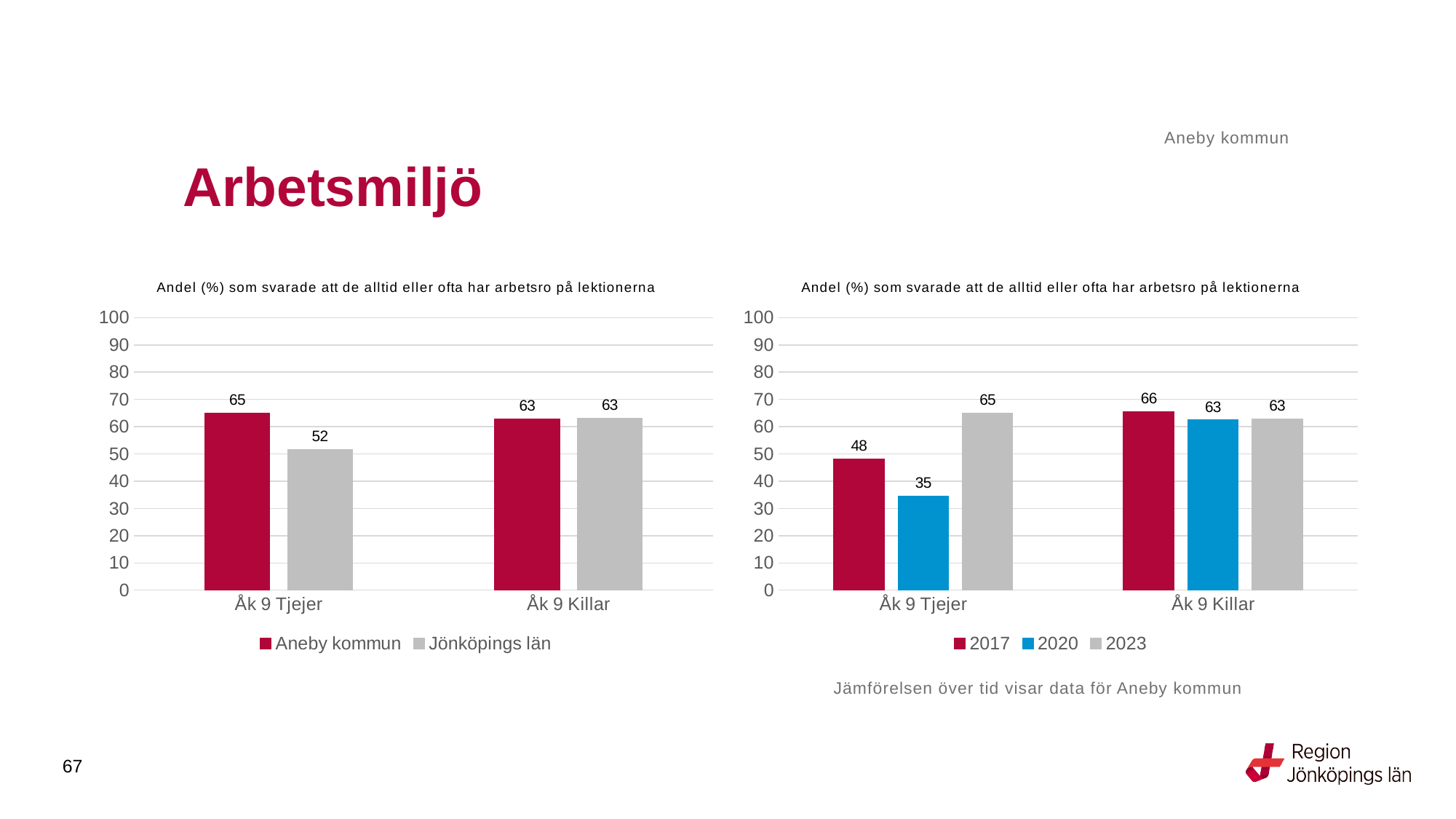
In the right chart, what is the difference between the 2023 and 2020 values for Åk 9 Tjejer? 30 In the right chart, what is the value for 2017 for Åk 9 Killar? 66 In the left chart, what is the value for Jönköpings län for Åk 9 Tjejer? 52 In the right chart, which year has the lowest value for Åk 9 Tjejer? 2020 What kind of chart is the right chart? Bar chart In the right chart, what is the value for 2020 for Åk 9 Tjejer? 35 In the right chart, which year has the highest value for Åk 9 Tjejer? 2023 How many series does the legend of the left chart list? 2 In the left chart, what is the difference between Aneby kommun and Jönköpings län for Åk 9 Tjejer? 13 How many series does the legend of the right chart list? 3 In the left chart, which is larger for Åk 9 Killar: Aneby kommun or Jönköpings län, or are they equal? They are equal (63) In the left chart, what is the value for Aneby kommun for Åk 9 Tjejer? 65